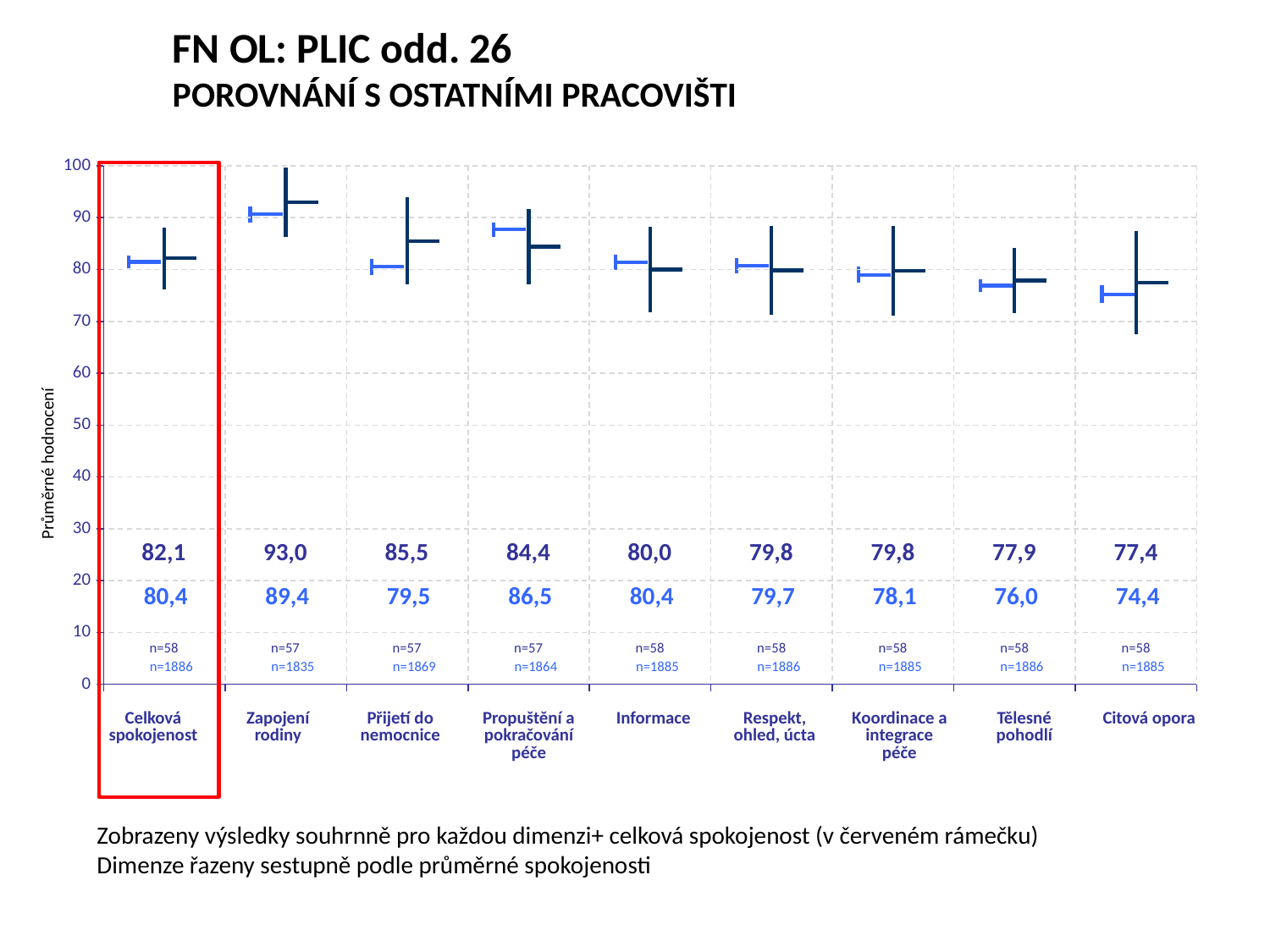
What is the difference between the dark blue and light blue values for Přijetí do nemocnice? 6,0 What is the light blue (lower) value printed for Propuštění a pokračování péče? 86,5 What is the light blue (lower) value printed for Citová opora? 74,4 What is the n value printed in the first line under Zapojení rodiny? n=57 What is the dark blue (upper) value printed for Celková spokojenost? 82,1 Which category is highlighted with a red frame? Celková spokojenost What is the dark blue (upper) value printed for Zapojení rodiny? 93,0 Which category has the lowest light blue (lower) value? Citová opora Do the dark blue (upper) values generally rise or fall from Zapojení rodiny to Citová opora along the x axis? fall For Propuštění a pokračování péče, which is larger: the dark blue value or the light blue value? the light blue value (86,5) How many categories are shown along the x axis? 9 Which category has the highest dark blue (upper) value? Zapojení rodiny